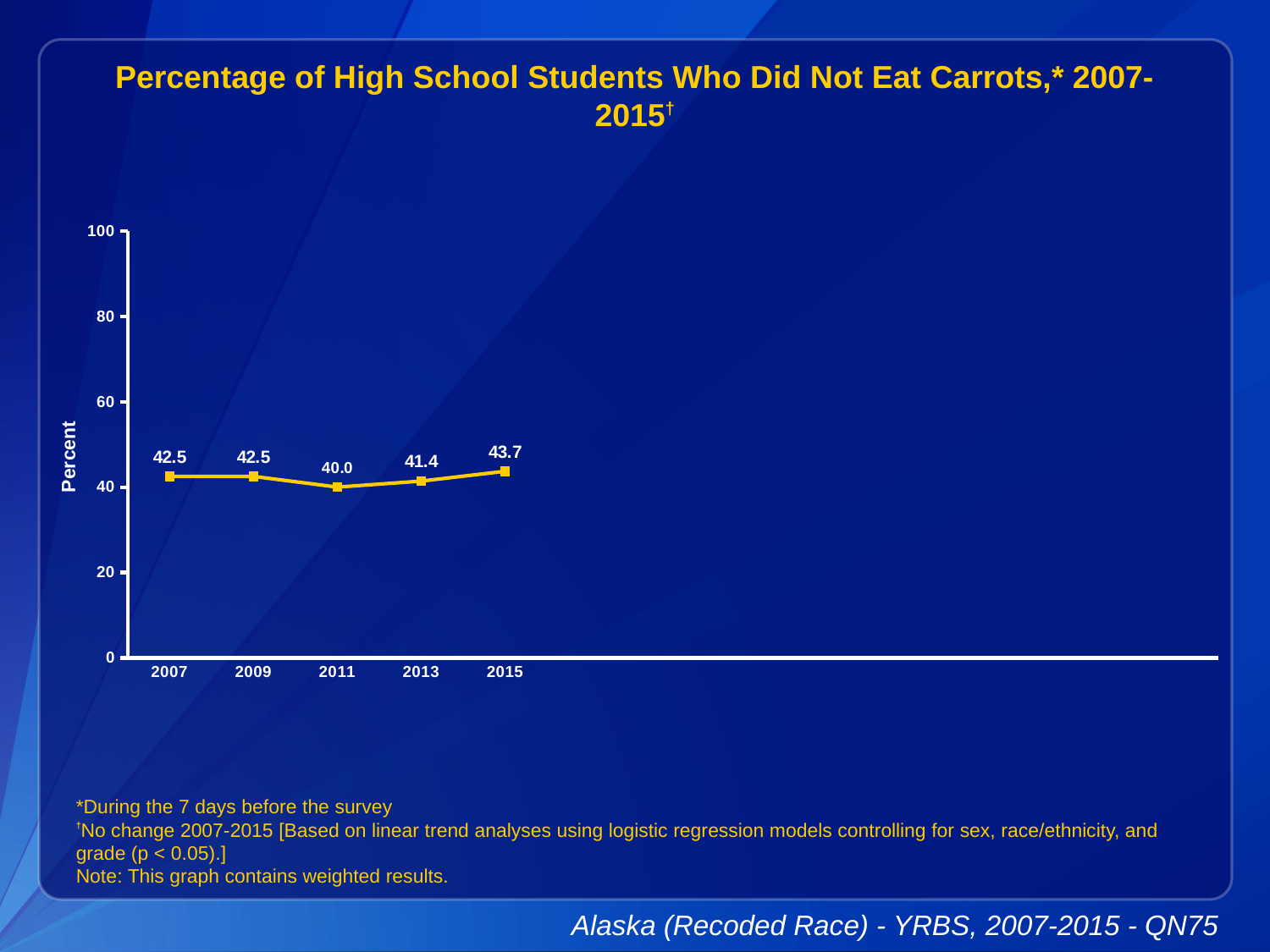
What kind of chart is shown on the slide? line chart What percentage of high school students did not eat carrots in 2011? 40.0 Do the values rise or fall from 2011 to 2015? rise What is the value plotted for 2015? 43.7 How many years are plotted on the chart? 5 Which year has the highest percentage of students who did not eat carrots? 2015 What is the difference between the 2015 value and the 2011 value? 3.7 Which year has the lowest percentage of students who did not eat carrots? 2011 Is the value for 2007 greater or less than 60? less What is the value plotted for 2013? 41.4 What is the label on the vertical axis? Percent Which year has a larger value, 2013 or 2015? 2015